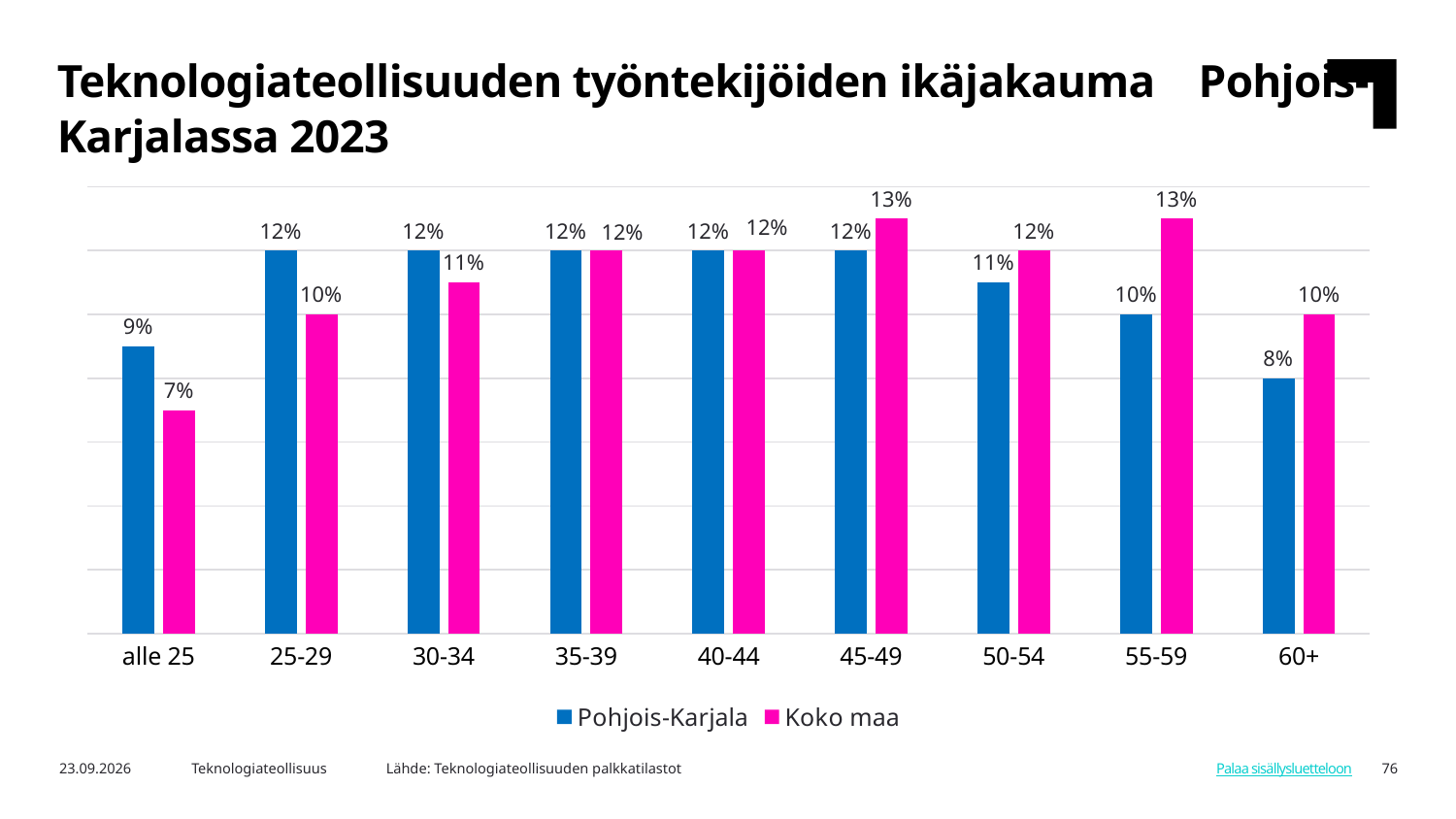
What is the value for Koko maa in the '55-59' age group? 13% How many age groups are shown on the x axis? 9 What is the value for Pohjois-Karjala in the '60+' age group? 8% Which colour represents the Koko maa series in the chart? pink What is the value for Koko maa in the '30-34' age group? 11% How many series does the legend list? 2 What is the difference between Koko maa and Pohjois-Karjala in the '55-59' age group? 3 percentage points What kind of chart is shown on the slide? bar chart In the '25-29' age group, which series has the larger value, Pohjois-Karjala or Koko maa? Pohjois-Karjala Which age group has the lowest value for Koko maa? alle 25 What is the value for Pohjois-Karjala in the 'alle 25' age group? 9% Which age group has the lowest value for Pohjois-Karjala? 60+